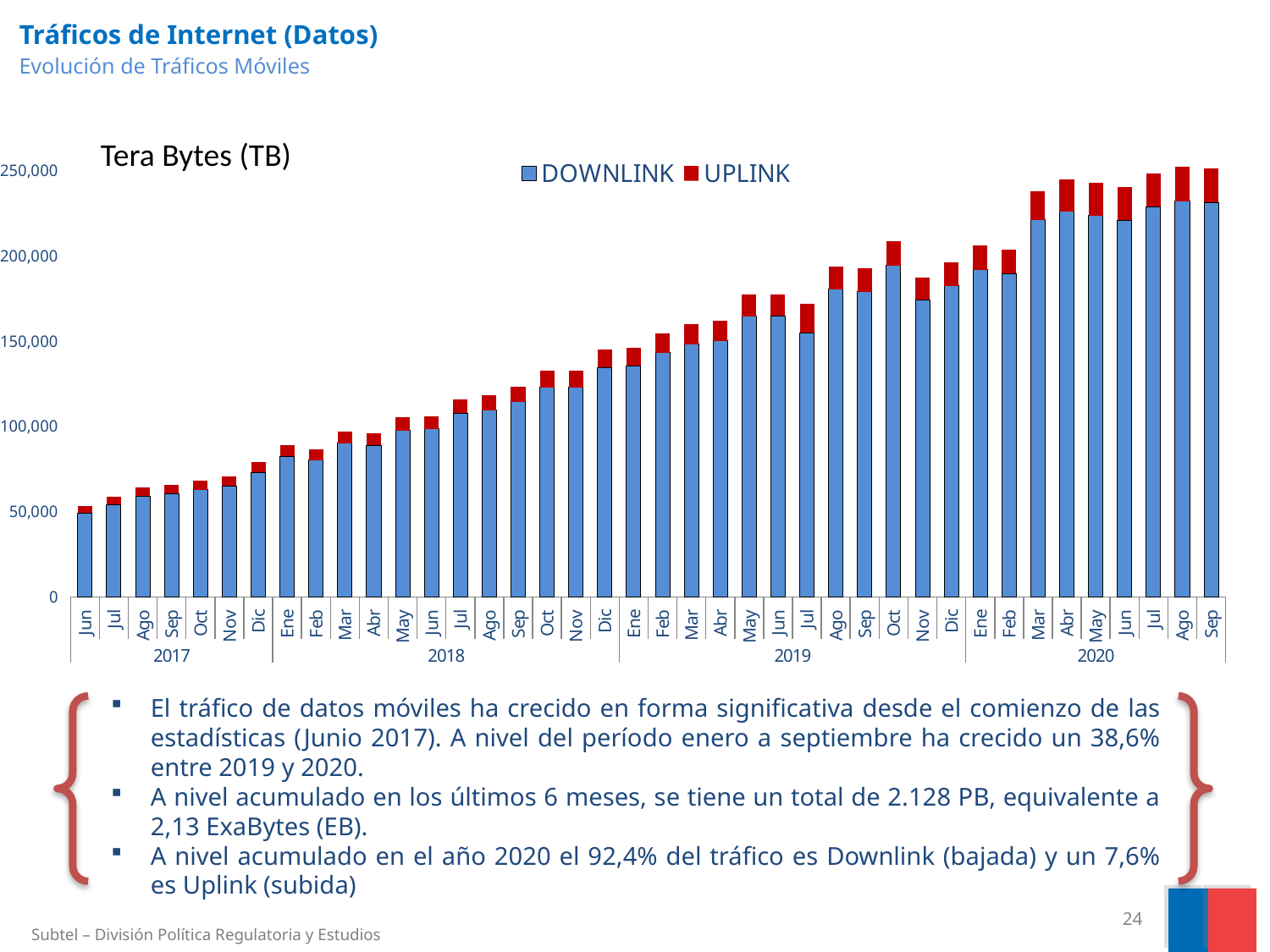
Is the total traffic for Jun 2017 greater or less than 100,000? less Is the total traffic for Mar 2020 greater or less than 200,000? greater How many monthly bars are plotted in the chart? 40 Is the total traffic for Ene 2018 greater or less than 100,000? less Which month has the larger total traffic, Jun 2019 or Jul 2019? Jun 2019 How many series does the chart legend list? 2 What colour represents the UPLINK series in the chart? red Which month has the lowest total traffic in the chart? Jun 2017 What kind of chart is shown on the slide? bar chart Do the total traffic values generally rise or fall from Jun 2017 to Sep 2020? rise Which two series are listed in the chart legend? DOWNLINK and UPLINK Which month has the larger total traffic, Oct 2019 or Nov 2019? Oct 2019